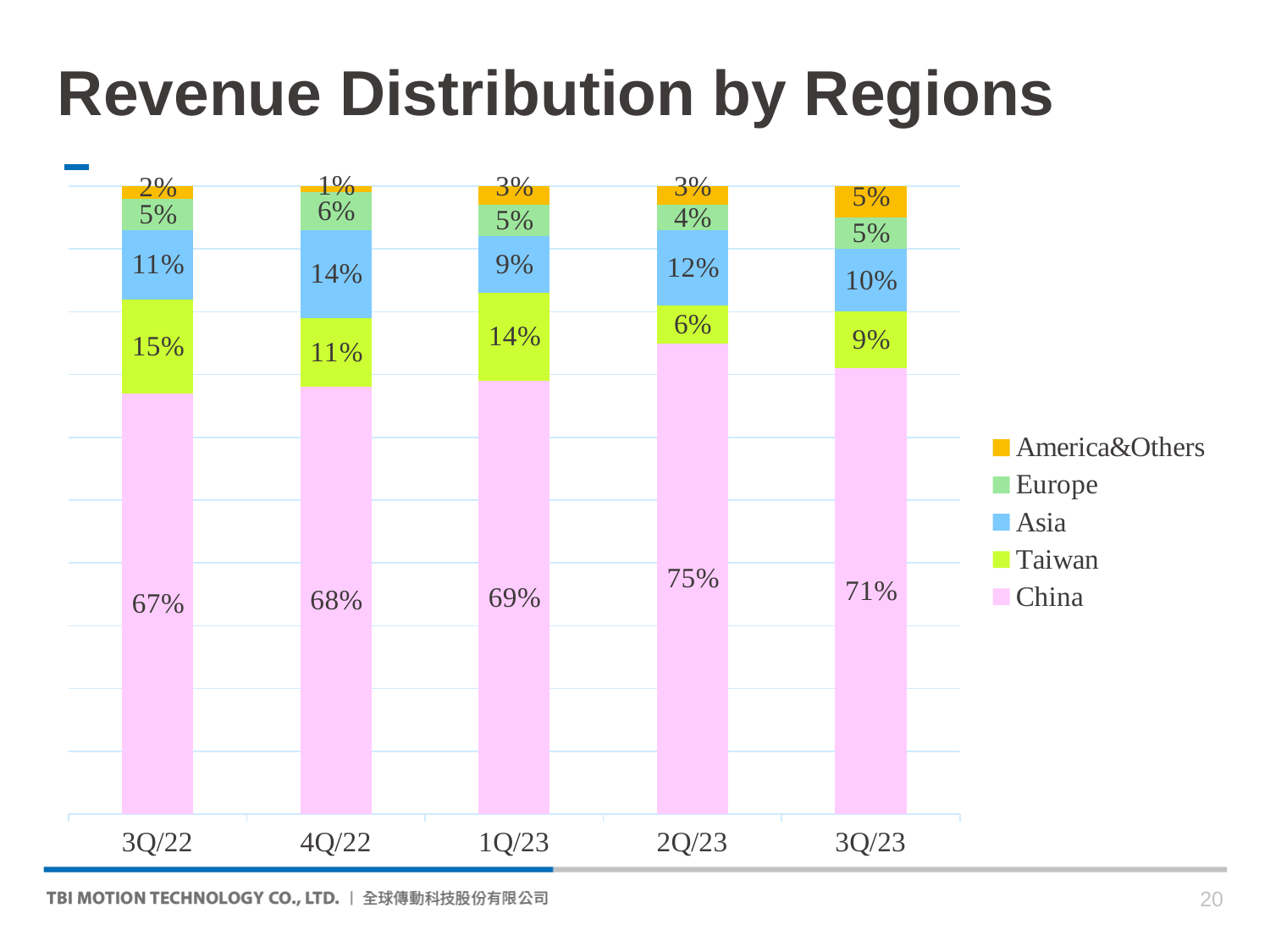
In which quarter is the China share of revenue highest? 2Q/23 What share of revenue came from China in 2Q/23? 75% How many regions does the legend list? 5 What is the Taiwan share of revenue in 3Q/22? 15% Which region is shown in pink in the chart? China What kind of chart is shown on the slide? Stacked bar chart What is the America&Others share of revenue in 3Q/23? 5% In which quarter is the Taiwan share of revenue lowest? 2Q/23 How many quarters are shown on the x axis? 5 Which is larger in 1Q/23, the Taiwan share or the Asia share? Taiwan What is the Asia share of revenue in 4Q/22? 14% What is the difference between the China share in 2Q/23 and in 3Q/22? 8%